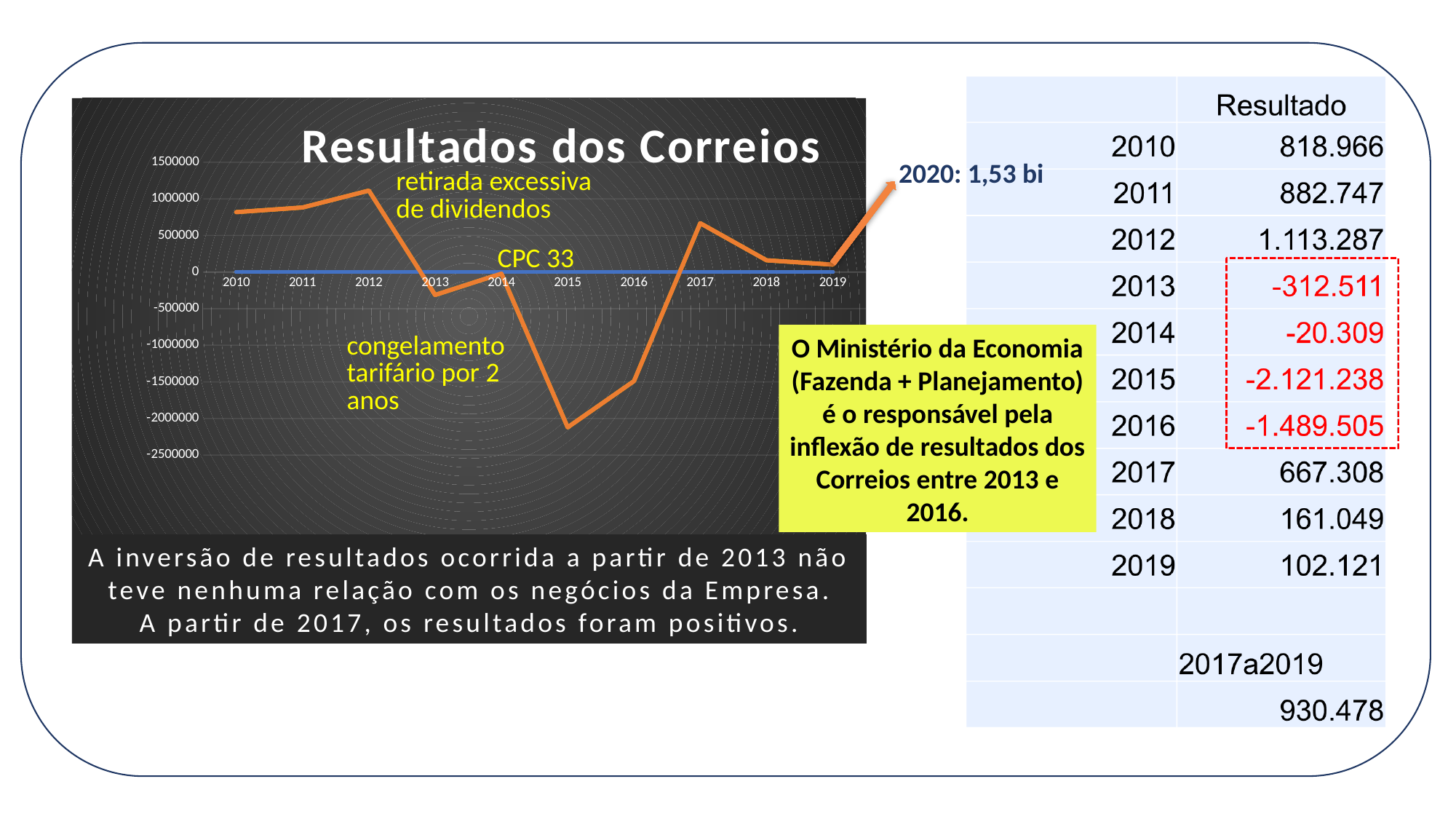
Is the value for 2015 in the chart greater or less than -2000000? less Which year has the highest value in the "Resultados dos Correios" chart? 2012 What is the result (Resultado) for 2012? 1.113.287 How many years are plotted on the x axis of the "Resultados dos Correios" chart? 10 Which year has the lowest value in the "Resultados dos Correios" chart? 2015 What is the difference between the results for 2017 (667.308) and 2018 (161.049)? 506.259 Which is larger, the result for 2010 or the result for 2012? 2012 Is the value for 2017 in the chart greater or less than 500000? greater Does the line rise or fall from 2012 to 2015 in the "Resultados dos Correios" chart? fall What kind of chart is "Resultados dos Correios"? line chart What is the title of the chart on the slide? Resultados dos Correios What is the result (Resultado) for 2015? -2.121.238